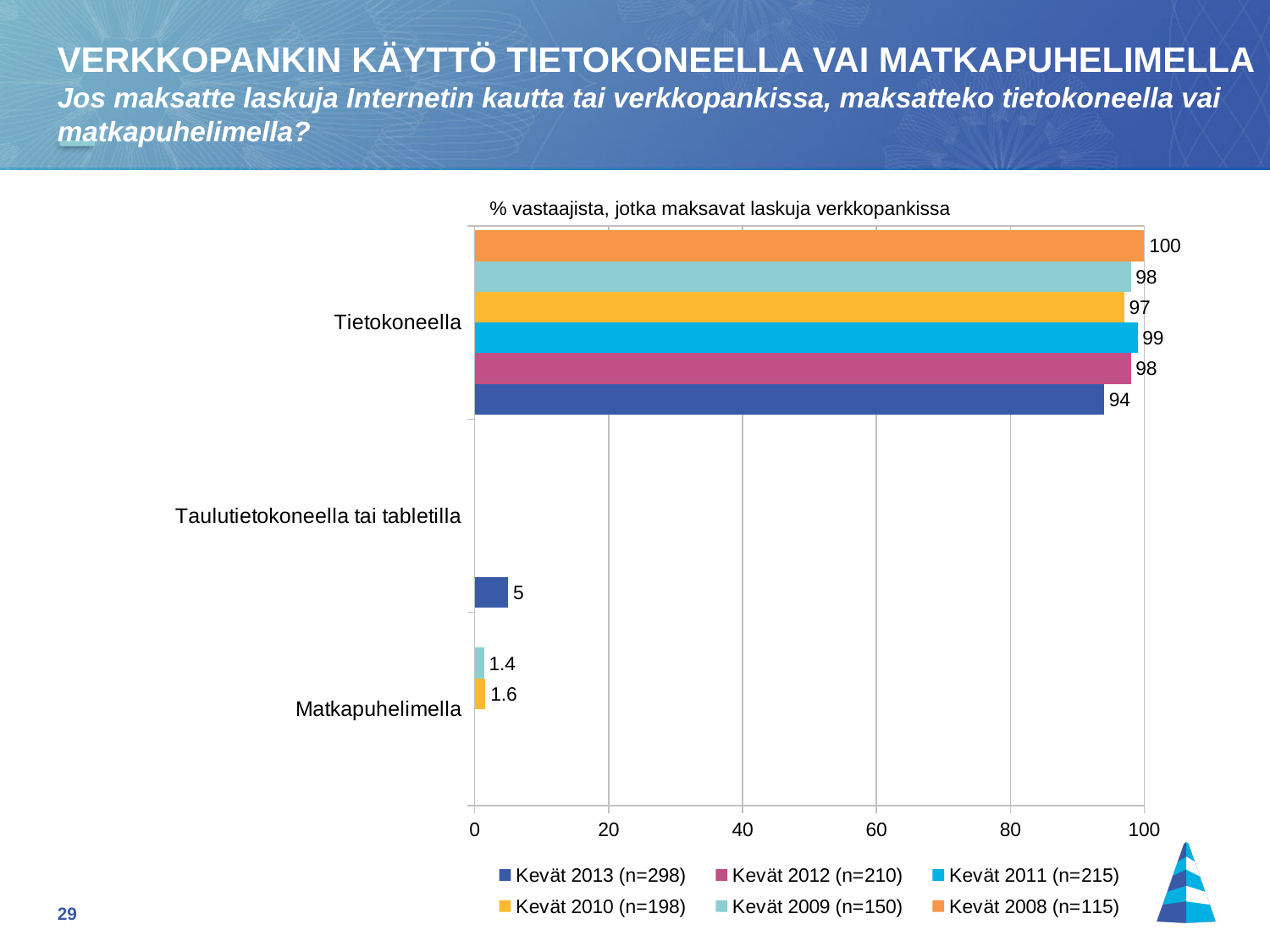
Which series has the highest value for Tietokoneella? Kevät 2008 (n=115) What is the difference between the Tietokoneella values for Kevät 2008 (n=115) and Kevät 2013 (n=298)? 6 What is the value for Tietokoneella in Kevät 2011 (n=215)? 99 What is the value for Tietokoneella in Kevät 2013 (n=298)? 94 How many categories are shown on the vertical axis? 3 Which series has the lowest value for Tietokoneella? Kevät 2013 (n=298) What is the value for Taulutietokoneella tai tabletilla in Kevät 2013 (n=298)? 5 What kind of chart is shown on the slide? bar chart What is the text shown above the chart describing what the values represent? % vastaajista, jotka maksavat laskuja verkkopankissa How many series does the legend list? 6 What is the value for Tietokoneella in Kevät 2008 (n=115)? 100 What is the value for Matkapuhelimella in Kevät 2010 (n=198)? 1.6